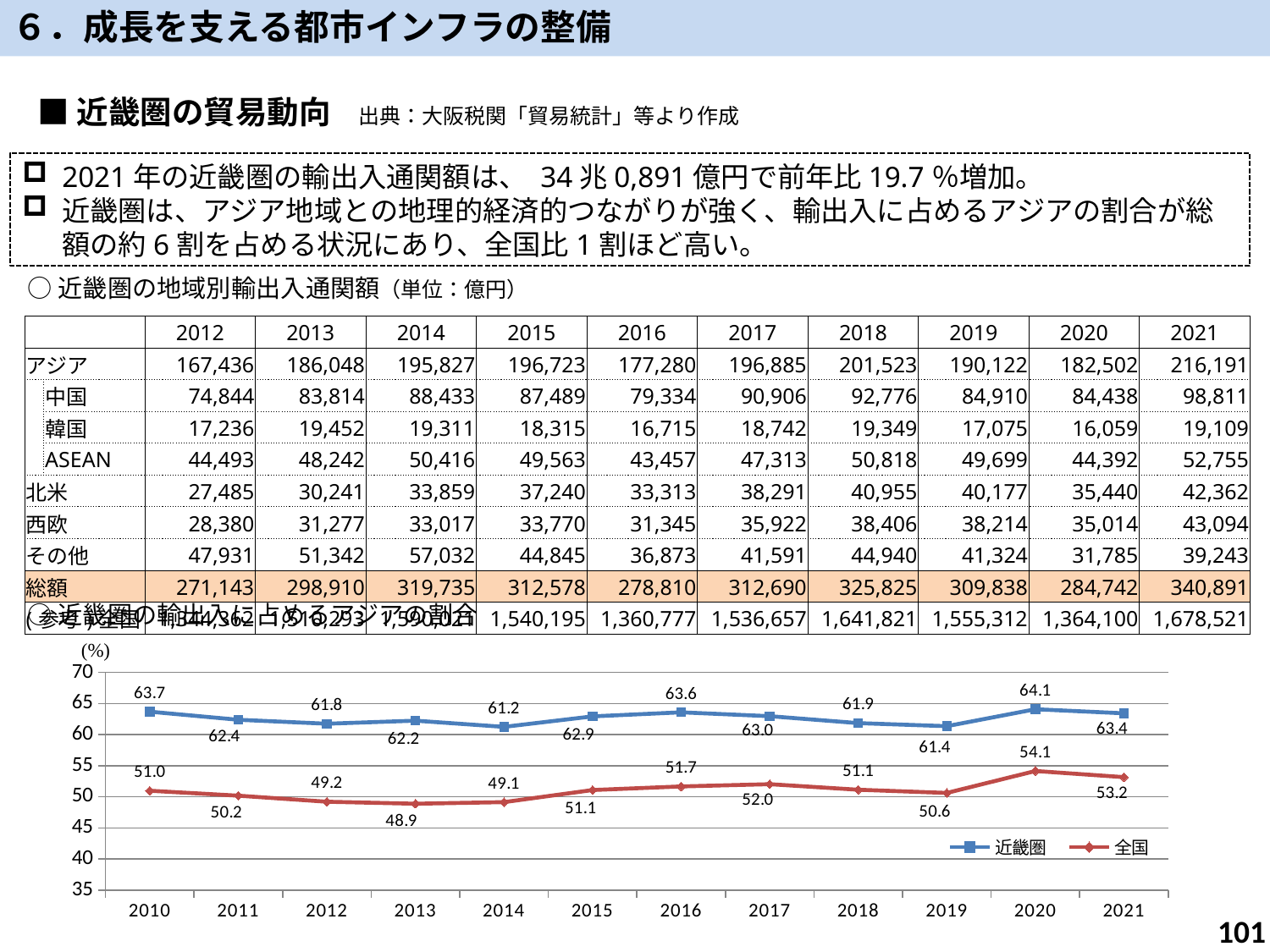
In which year is the 近畿圏 series lowest in the line chart? 2014 How many years are plotted on the x axis of the line chart? 12 What is the value for 全国 in 2013 in the line chart? 48.9 How many series does the legend of the line chart list? 2 What is the difference between the 近畿圏 and 全国 values in 2021 in the line chart? 10.2 What colour is the 全国 line in the line chart? red Does the 全国 series rise or fall from 2019 to 2020 in the line chart? rise What is the value for 近畿圏 in 2020 in the line chart? 64.1 Which series has the larger value in 2017 in the line chart, 近畿圏 or 全国? 近畿圏 In which year is the 全国 series highest in the line chart? 2020 What is the value for 近畿圏 in 2014 in the line chart? 61.2 What type of chart is shown at the bottom of the slide? line chart